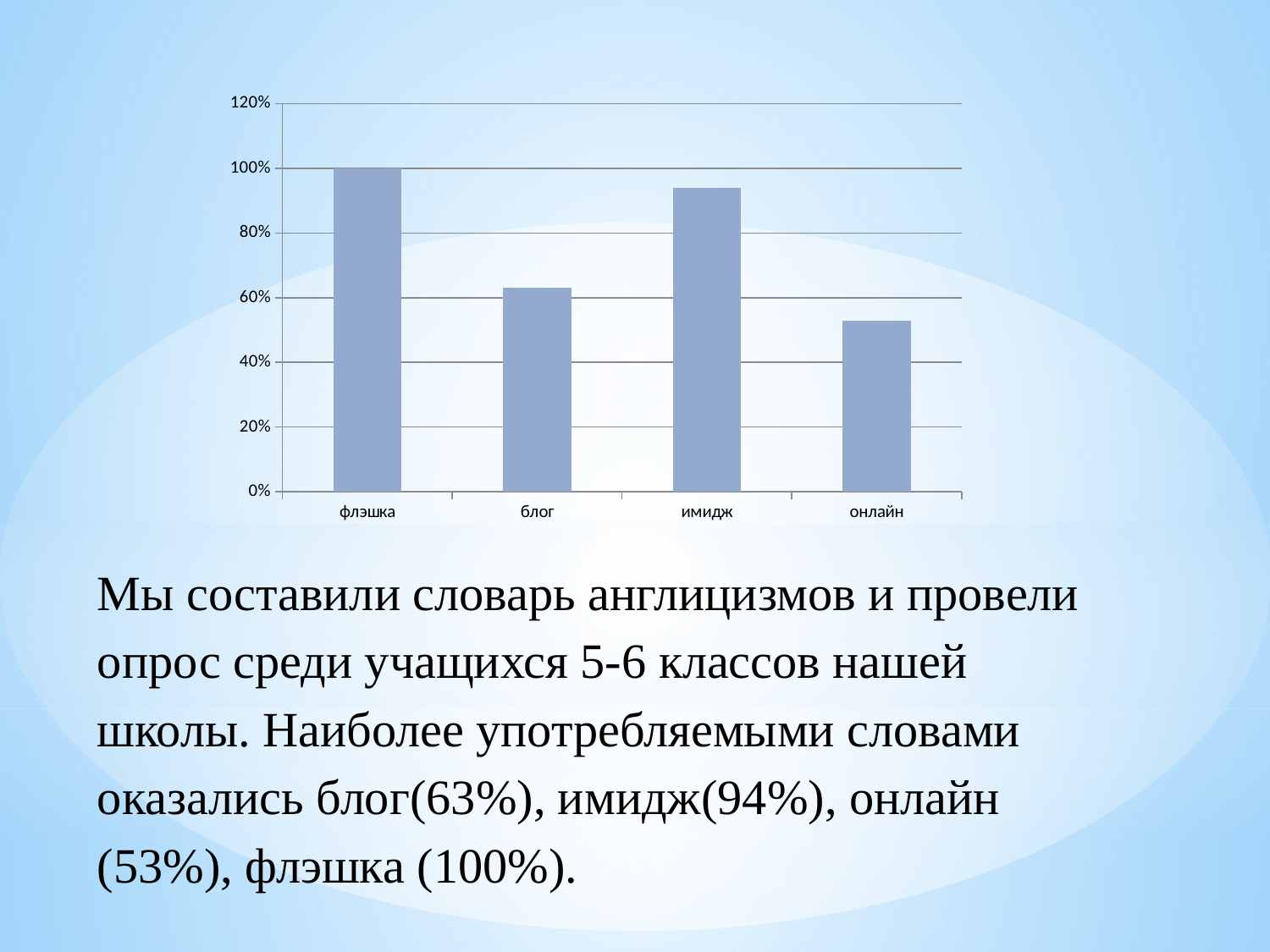
Is the value for блог greater or less than 60%? greater What is the value for онлайн in the chart? 53% Is the value for онлайн greater or less than 60%? less What is the value for флэшка in the chart? 100% How many categories are shown on the x axis of the chart? 4 Which category has the lowest bar in the chart? онлайн What is the difference between the values for флэшка and онлайн in the chart? 47% What is the value for блог in the chart? 63% What kind of chart is shown on the slide? bar chart Which is larger in the chart, the value for имидж or the value for блог? имидж Which category has the highest bar in the chart? флэшка What is the value for имидж in the chart? 94%